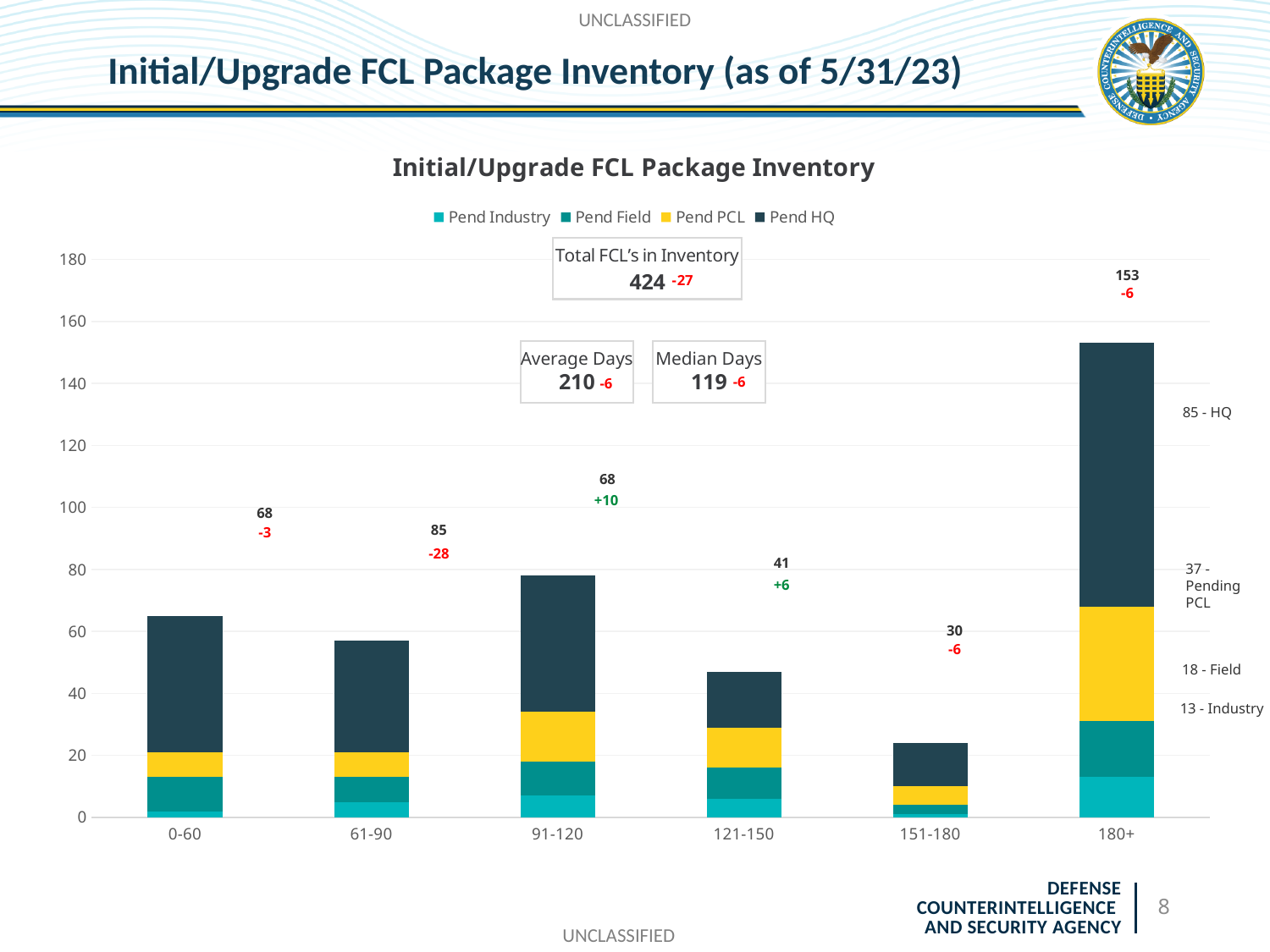
Which category has the tallest bar? 180+ How many series does the legend list? 4 What is the HQ value labeled for the 180+ bar? 85 What is the total printed above the 180+ bar? 153 Which bar is taller, 91-120 or 121-150? 91-120 What kind of chart is shown on the slide? Stacked bar chart What is the difference between the HQ value (85) and the Field value (18) labeled on the 180+ bar? 67 Is the bar for 151-180 greater or less than 40? less What is the Pending PCL value labeled for the 180+ bar? 37 How many categories are shown on the x axis? 6 What is the Total FCL's in Inventory value shown in the box on the chart? 424 Which category has the shortest bar? 151-180